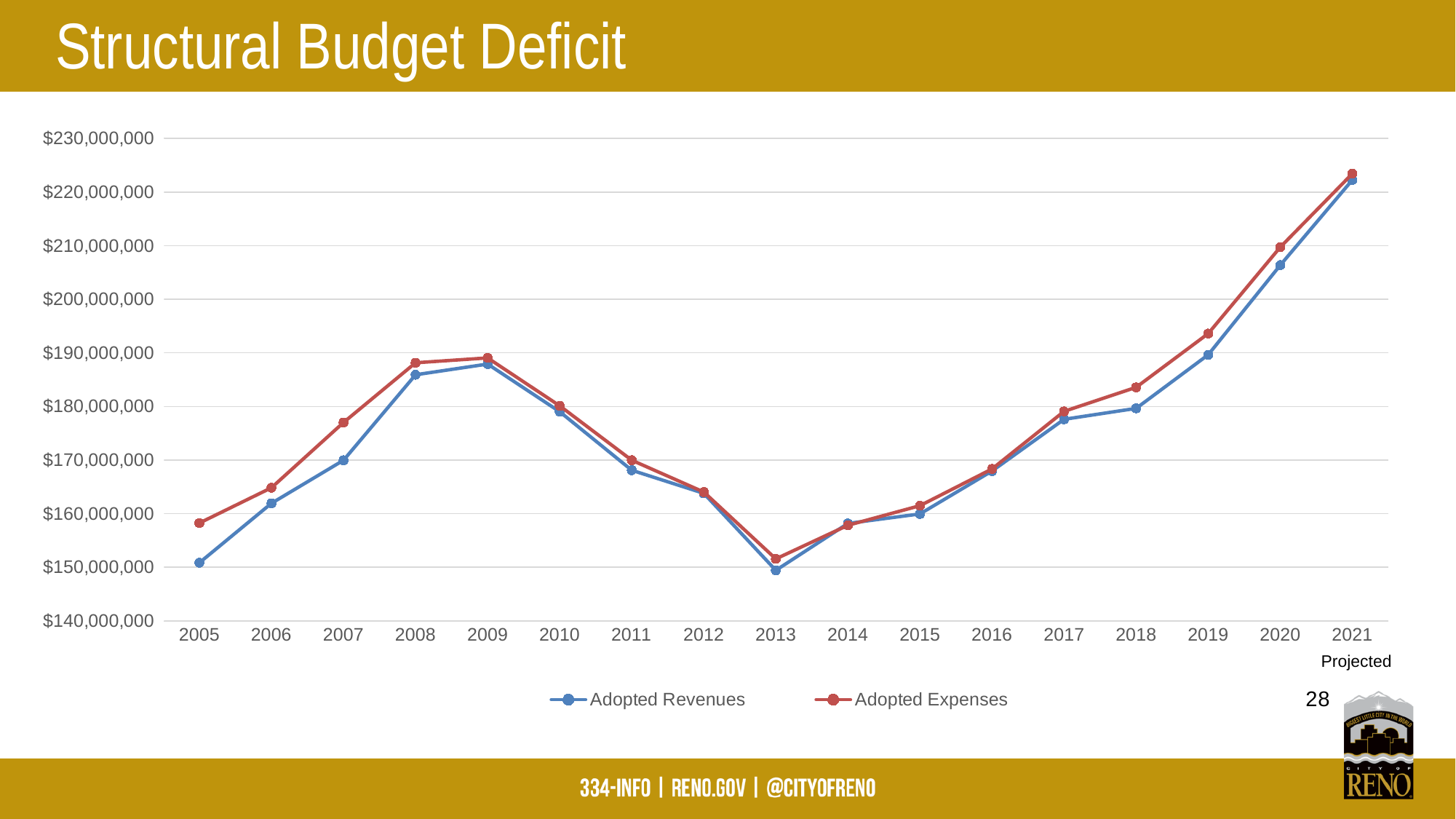
Which year on the x axis is marked as Projected? 2021 Is the value for Adopted Expenses in 2020 greater or less than $200,000,000? greater Do Adopted Revenues rise or fall from 2013 to 2021? rise How many series does the legend list? 2 In which year is Adopted Expenses highest? 2021 What kind of chart is shown on the slide? line chart How many years are plotted along the x axis? 17 In which year is Adopted Revenues lowest? 2013 Is the value for Adopted Revenues in 2005 greater or less than $160,000,000? less Is the value for Adopted Revenues in 2009 greater or less than $180,000,000? greater In 2005, which is larger: Adopted Revenues or Adopted Expenses? Adopted Expenses Do Adopted Expenses rise or fall from 2009 to 2013? fall